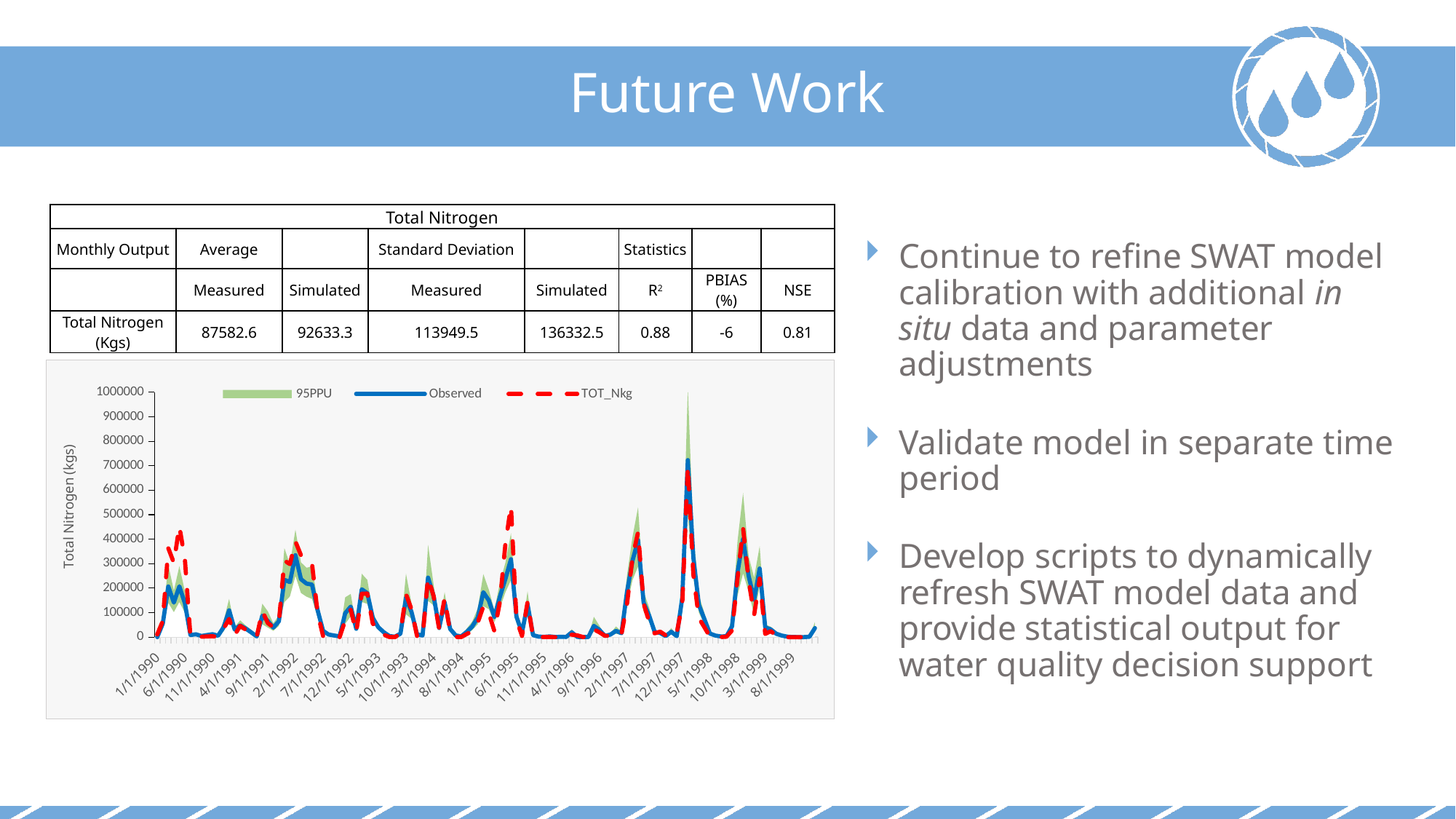
Around which x-axis date does the Observed series reach its highest peak? 12/1/1997 What is the highest value shown on the chart's vertical axis? 1000000 How many series does the chart legend list? 3 Is the peak of the TOT_Nkg series near 6/1/1990 greater or less than 300000? greater Which is larger: the Observed peak near 12/1/1997 or the Observed peak near 6/1/1990? the peak near 12/1/1997 What are the three series named in the chart legend? 95PPU, Observed, TOT_Nkg What kind of chart is shown on the slide? combination area and line chart Is the peak of the Observed series near 12/1/1997 greater or less than 600000? greater Is the top of the 95PPU band near 12/1/1997 greater or less than 900000? greater How many date labels are shown along the chart's x axis? 24 What is the label on the chart's vertical axis? Total Nitrogen (kgs)